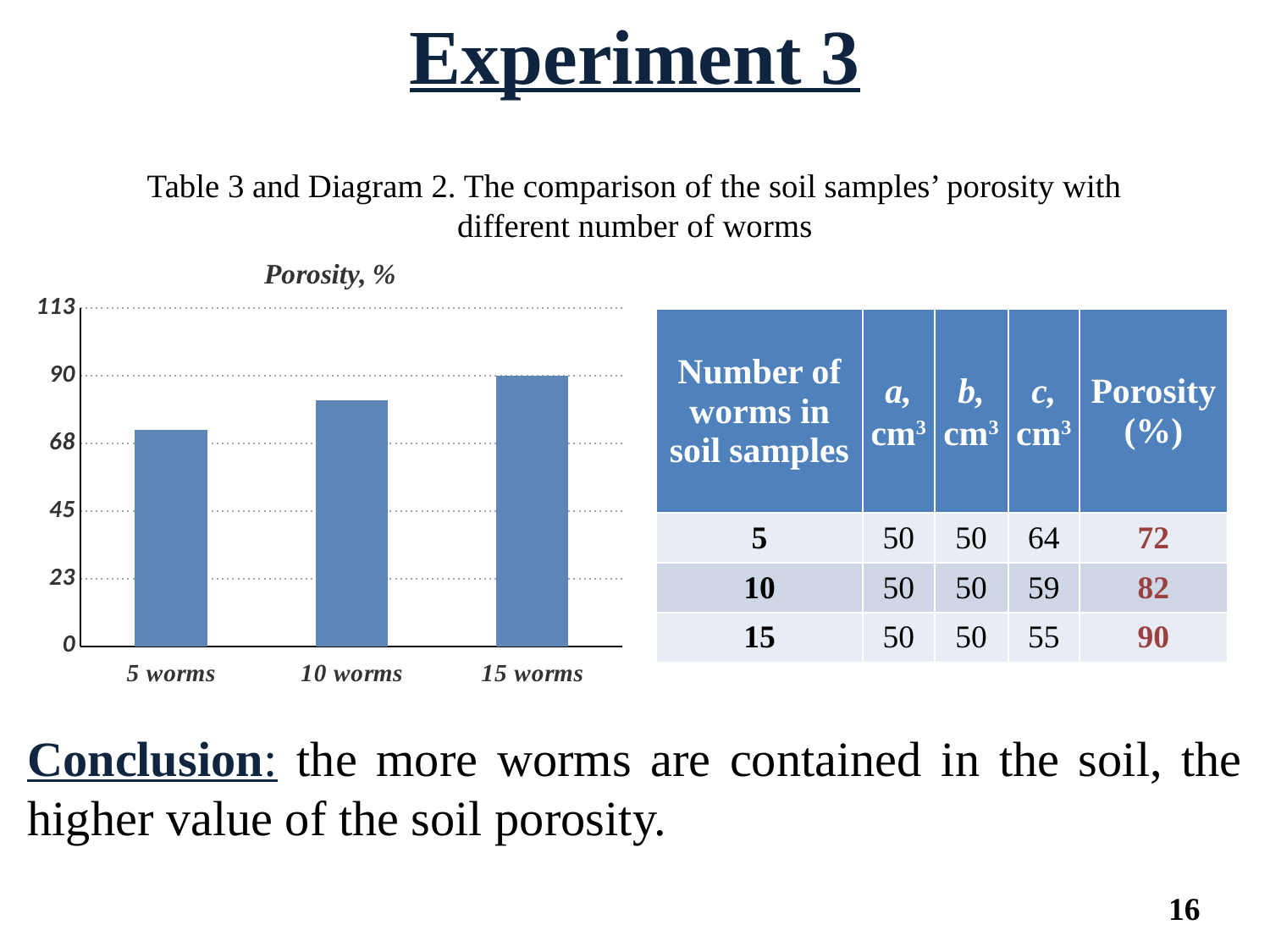
What kind of chart is shown on the slide? bar chart Do the porosity values rise or fall as the number of worms increases along the x axis? rise Is the porosity for 10 worms greater or less than 68? greater Which is larger, the porosity for 10 worms or for 5 worms? 10 worms According to the table, what is the porosity (%) for 10 worms? 82 Which category has the lowest porosity in the chart? 5 worms What is the label shown above the chart's vertical axis? Porosity, % What is the difference in porosity between 15 worms and 5 worms? 18 Which category has the highest porosity in the chart? 15 worms How many bars (categories) does the chart show? 3 According to the table, what is the porosity (%) for 5 worms? 72 What is the porosity value for 15 worms? 90